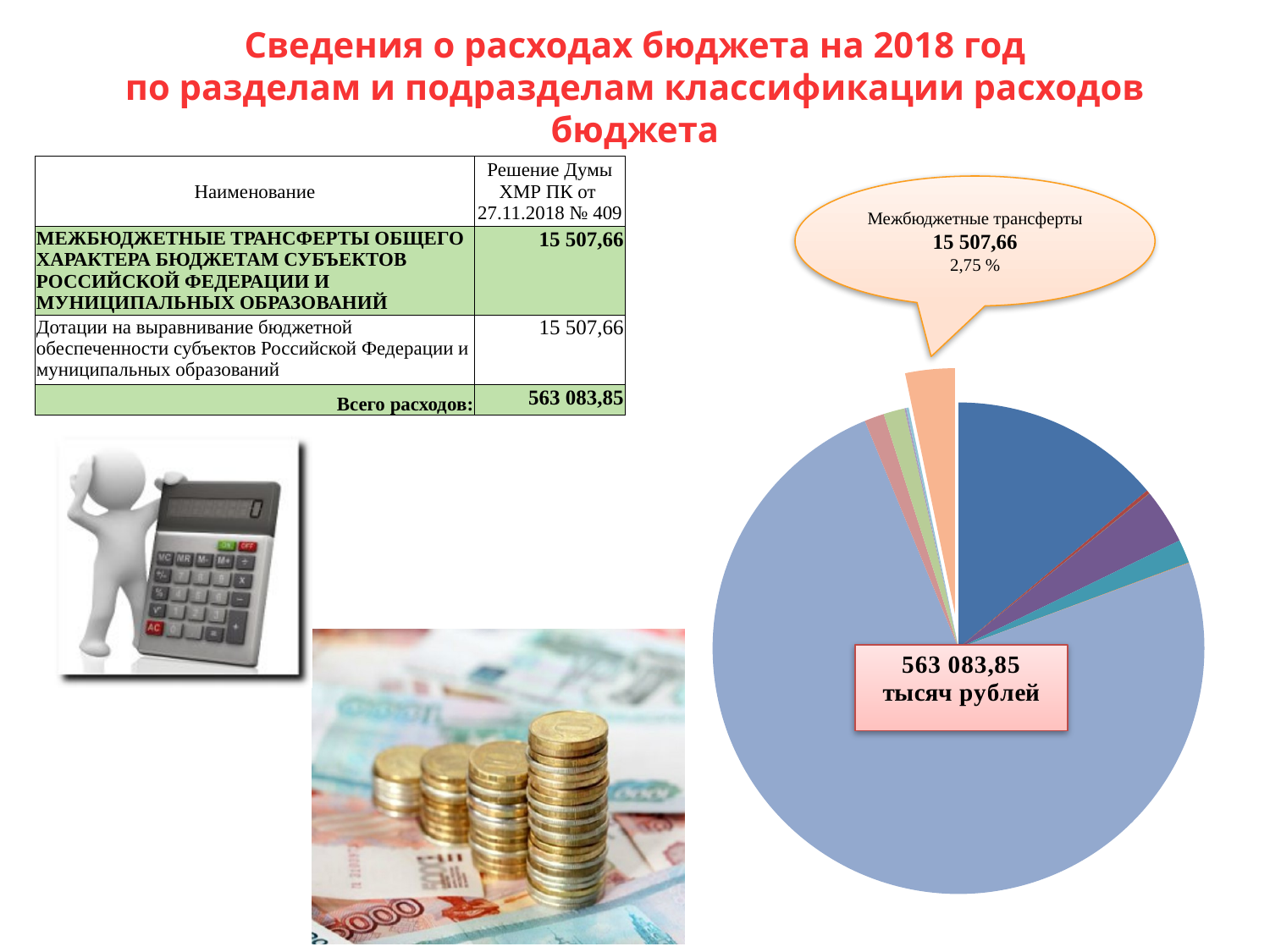
Which slice of the pie chart is pulled out (exploded) from the rest of the pie? Межбюджетные трансферты What total is shown in the box at the centre of the pie chart? 563 083,85 тысяч рублей What value is shown in the callout for the Межбюджетные трансферты slice of the pie chart? 15 507,66 Which is larger: the Межбюджетные трансферты slice or the large light blue slice of the pie chart? the large light blue slice Is the share of the Межбюджетные трансферты slice greater or less than 5%? less Is the Межбюджетные трансферты slice the largest slice of the pie chart? No Does the pie chart have a legend? No What share of the pie does the Межбюджетные трансферты slice represent, according to the callout? 2,75 % What kind of chart is shown on the right side of the slide? pie chart